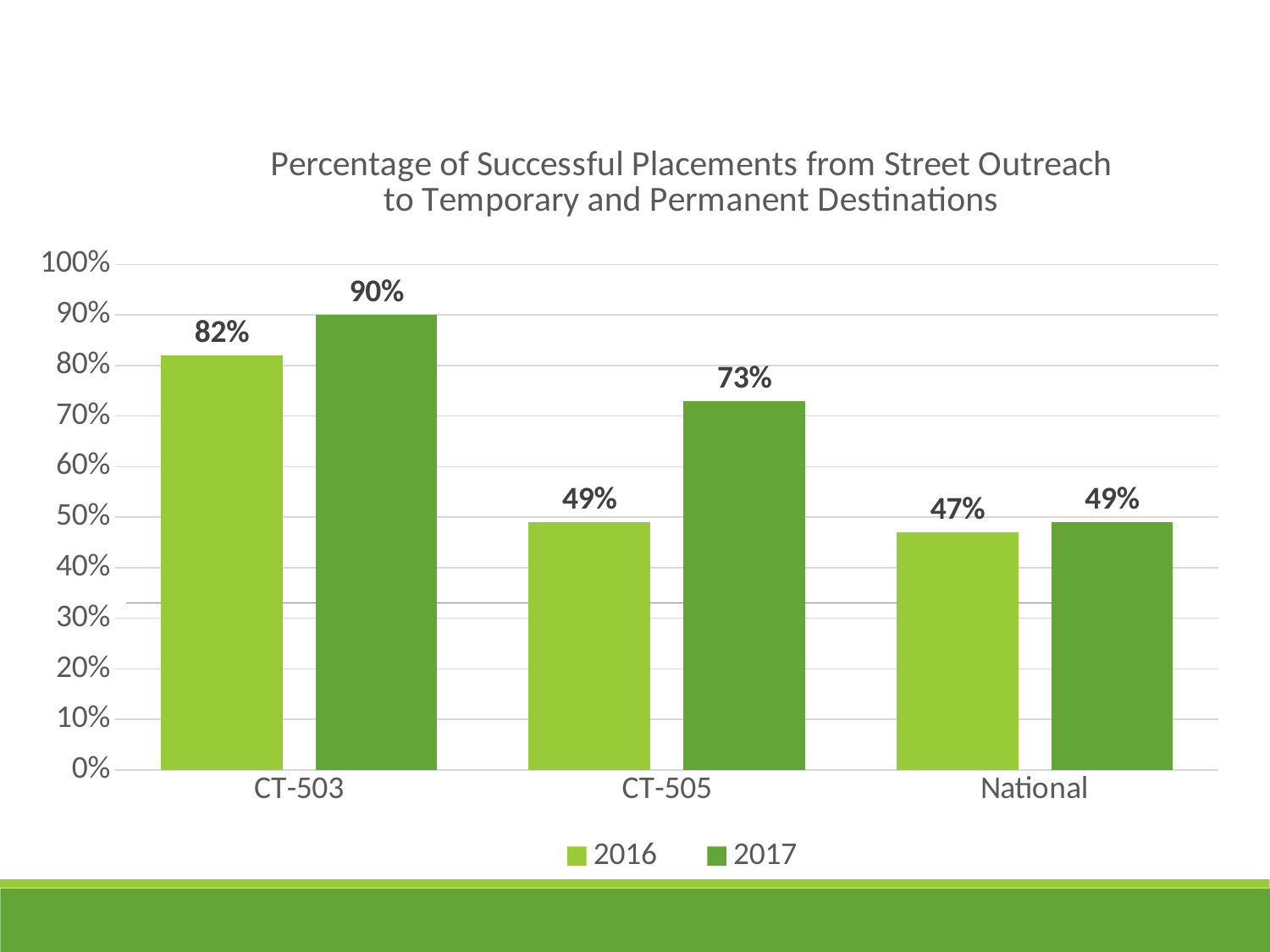
What is the 2016 value for CT-505? 49% What is the 2017 value for CT-503? 90% What is the 2016 value for National? 47% What is the difference between the 2017 and 2016 values for CT-505? 24% How many categories are shown on the x axis? 3 Which series does the darker green colour represent in the legend? 2017 Which category has the highest 2017 value? CT-503 What is the difference between the 2017 values for CT-503 and National? 41% Which is larger, the 2016 value for CT-503 or the 2017 value for CT-505? 2016 value for CT-503 How many series does the legend list? 2 What kind of chart is shown? Bar chart Which category has the lowest 2016 value? National